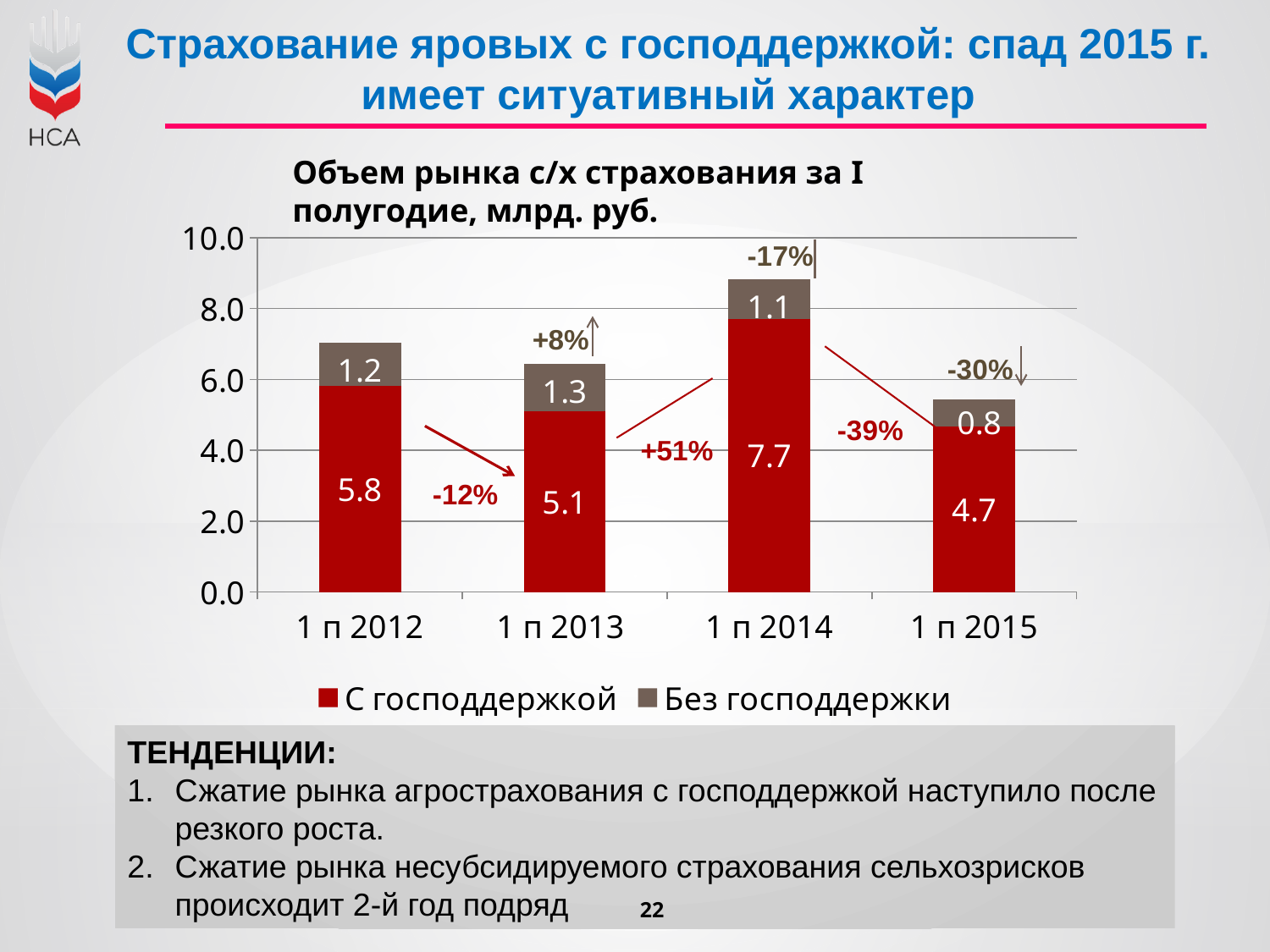
What percentage change is labelled between 1 п 2013 and 1 п 2014 for the 'С господдержкой' series? +51% What is the value for 'С господдержкой' in 1 п 2012? 5.8 Which is larger: the 'Без господдержки' value in 1 п 2013 or in 1 п 2014? 1 п 2013 In which period is the 'С господдержкой' value the highest? 1 п 2014 What is the value for 'Без господдержки' in 1 п 2015? 0.8 What type of chart is shown on the slide? Stacked bar chart How many periods are shown on the x axis? 4 What is the difference between the 'С господдержкой' values in 1 п 2014 and 1 п 2015? 3.0 What is the total of the stacked bar for 1 п 2012? 7.0 In which period is the 'Без господдержки' value the lowest? 1 п 2015 What is the value for 'С господдержкой' in 1 п 2014? 7.7 How many series does the legend list? 2